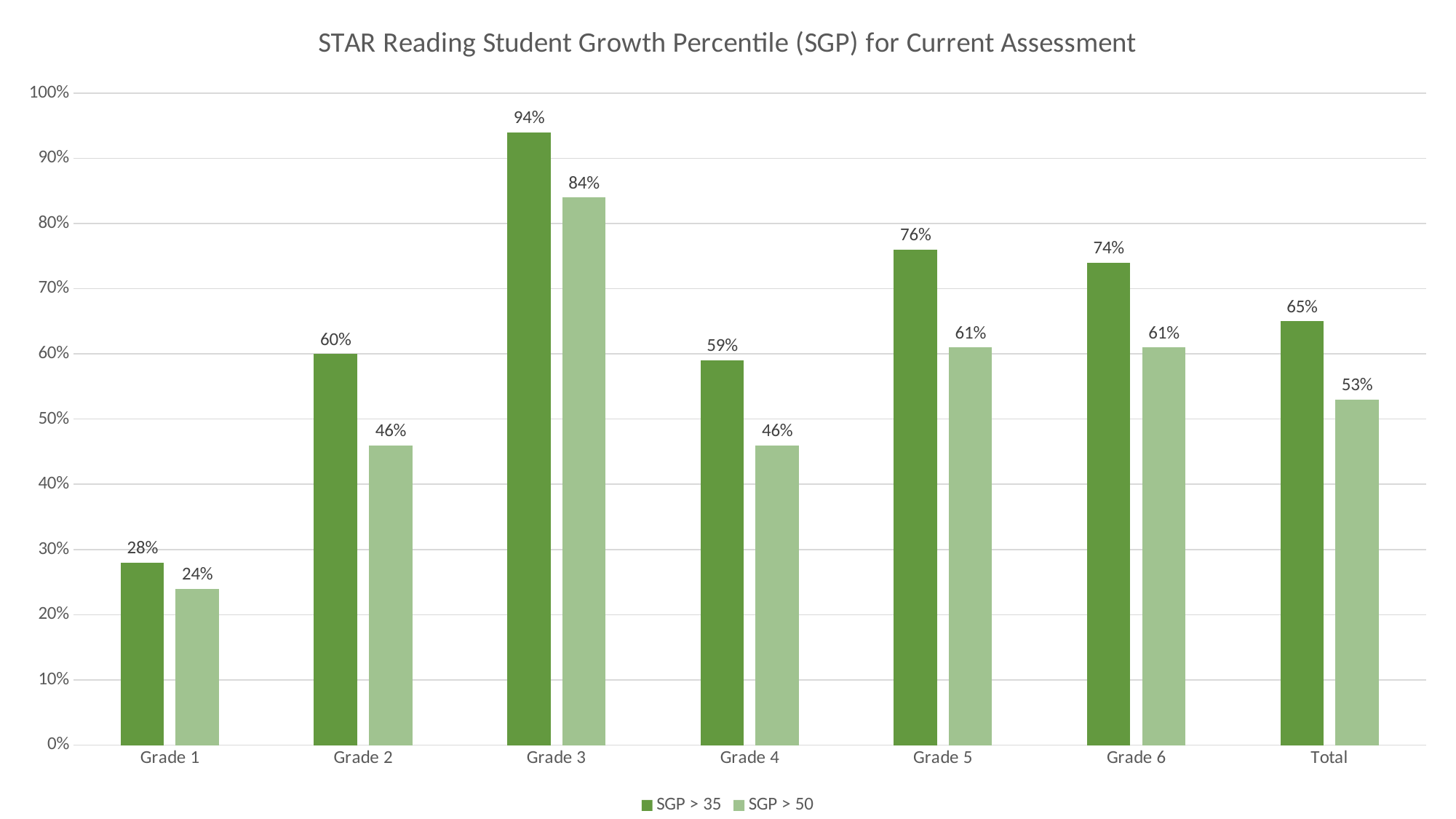
Which grade has the highest SGP > 35 value? Grade 3 What is the SGP > 50 value for Grade 1? 24% What is the SGP > 50 value for Total? 53% Is the SGP > 35 value for Grade 4 greater or less than 50%? greater What kind of chart is shown on the slide? Bar chart Which is larger: the SGP > 35 value for Grade 5 or for Grade 6? Grade 5 What is the difference between the SGP > 35 and SGP > 50 values for Grade 2? 14% Which category has the lowest SGP > 50 value? Grade 1 What is the title of the chart? STAR Reading Student Growth Percentile (SGP) for Current Assessment What is the SGP > 35 value for Grade 3? 94% How many series does the legend list? 2 How many categories are shown on the x axis? 7